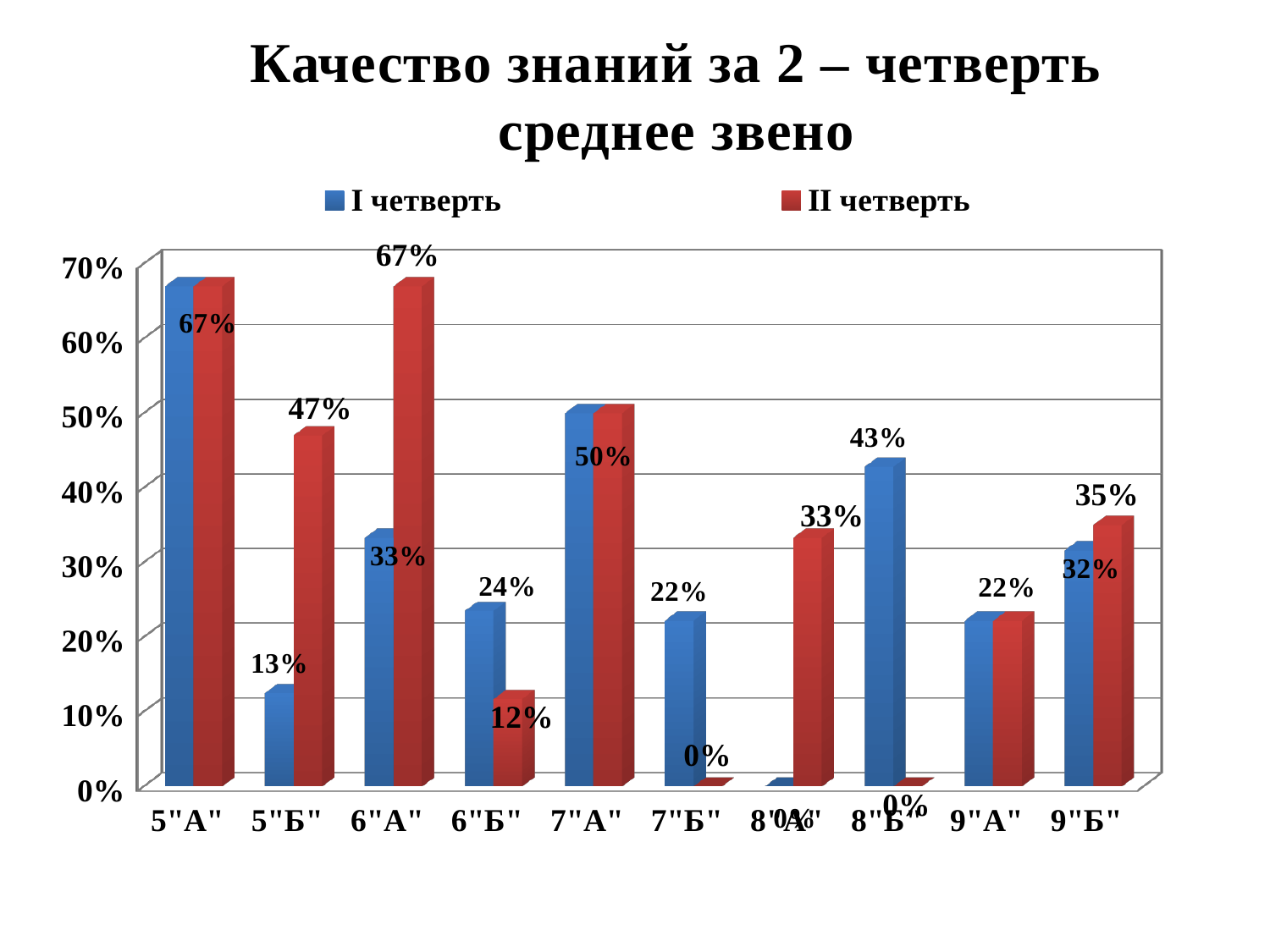
Which class has the highest value in the I четверть series? 5"А" What is the value for 7"Б" in the II четверть series? 0% What is the value for 5"Б" in the II четверть series? 47% What is the value for 6"Б" in the I четверть series? 24% For 5"Б", how much higher is the II четверть value than the I четверть value? 34% What type of chart is shown on the slide? Bar chart What is the value for 6"А" in the II четверть series? 67% How many series does the legend list? 2 How many classes are shown on the x axis? 10 Which class has the lowest value in the I четверть series? 8"А" What is the value for 8"Б" in the I четверть series? 43% For 9"Б", which series has the larger value, I четверть or II четверть? II четверть